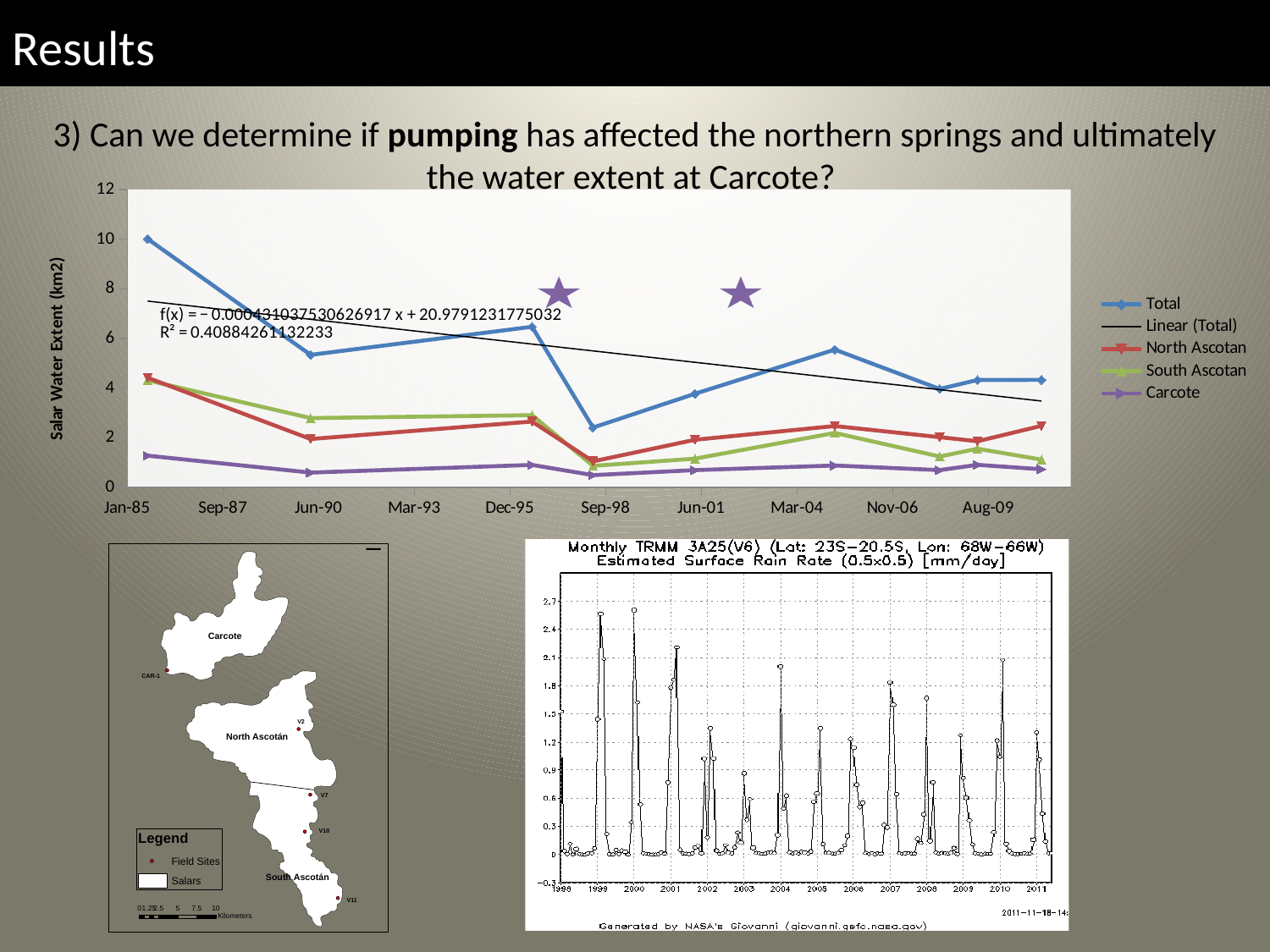
What kind of chart is the top chart showing Salar Water Extent? line chart In the top chart, is the value for Carcote at Jan-85 greater or less than 2? less In the top chart, what is the label on the vertical axis? Salar Water Extent (km2) In the top chart, does the Linear (Total) trend line rise or fall from left to right? fall In the top chart, is the value for Total at Dec-95 greater or less than 6? greater In the top chart, how many entries does the legend list? 5 In the top chart, which series has the highest values throughout? Total What kind of chart is the bottom-right chart of Estimated Surface Rain Rate? line chart In the top chart, which is larger at Jan-85: Total or North Ascotan? Total In the top chart, which series has the lowest values throughout? Carcote In the top chart, is the value for Total at Sep-98 greater or less than 4? less